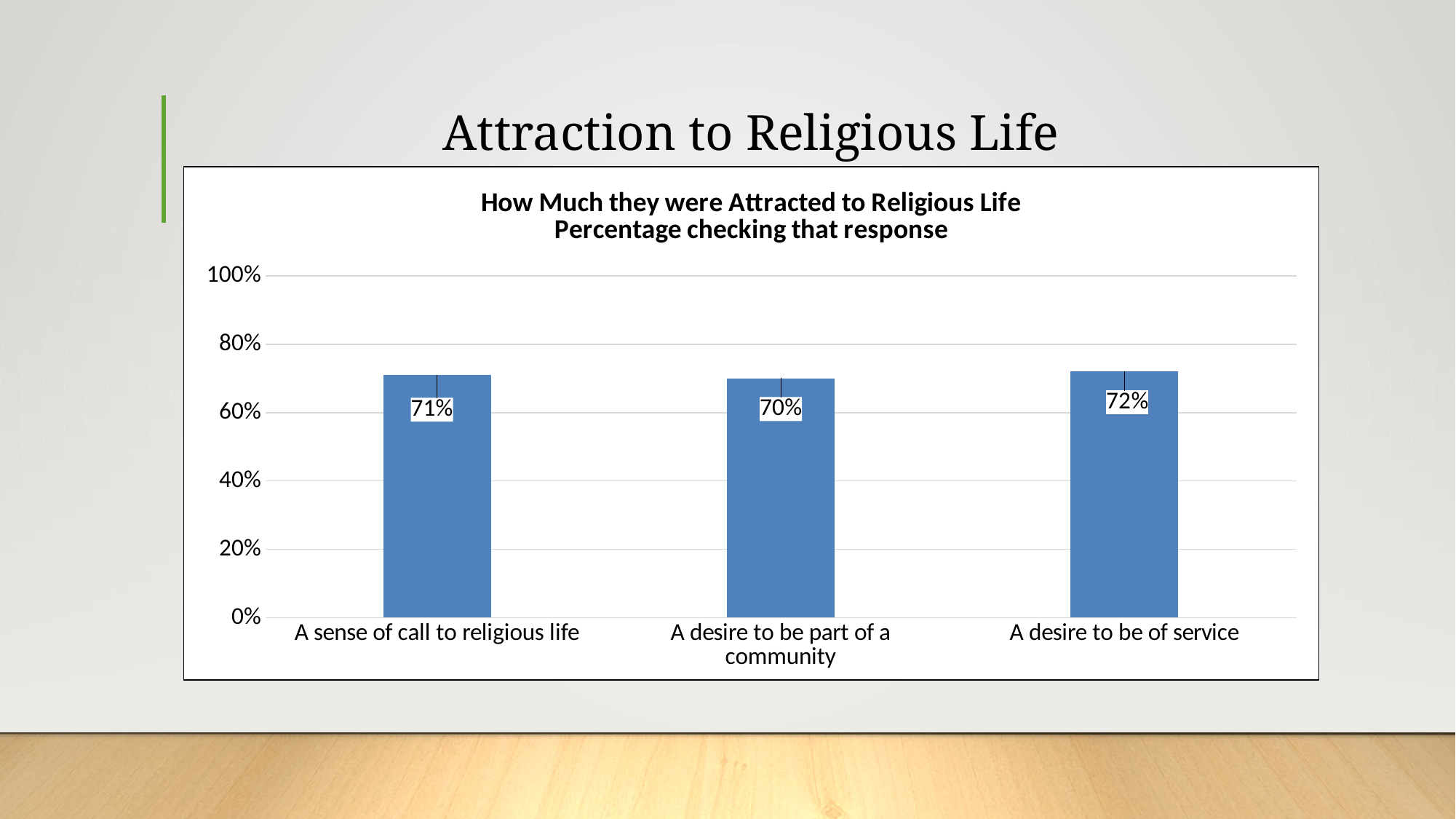
Which response has the highest percentage? A desire to be of service What percentage checked "A desire to be part of a community"? 70% Is the value for "A desire to be part of a community" greater or less than 60%? greater How many response categories are shown in the chart? 3 What is the title of the chart? How Much they were Attracted to Religious Life Percentage checking that response What kind of chart is shown on the slide? Bar chart Is the value for "A desire to be of service" greater or less than 80%? less What percentage checked "A desire to be of service"? 72% What is the difference in percentage points between "A desire to be of service" and "A desire to be part of a community"? 2 percentage points What percentage checked "A sense of call to religious life"? 71% Which is larger: the percentage for "A sense of call to religious life" or for "A desire to be part of a community"? A sense of call to religious life Which response has the lowest percentage? A desire to be part of a community